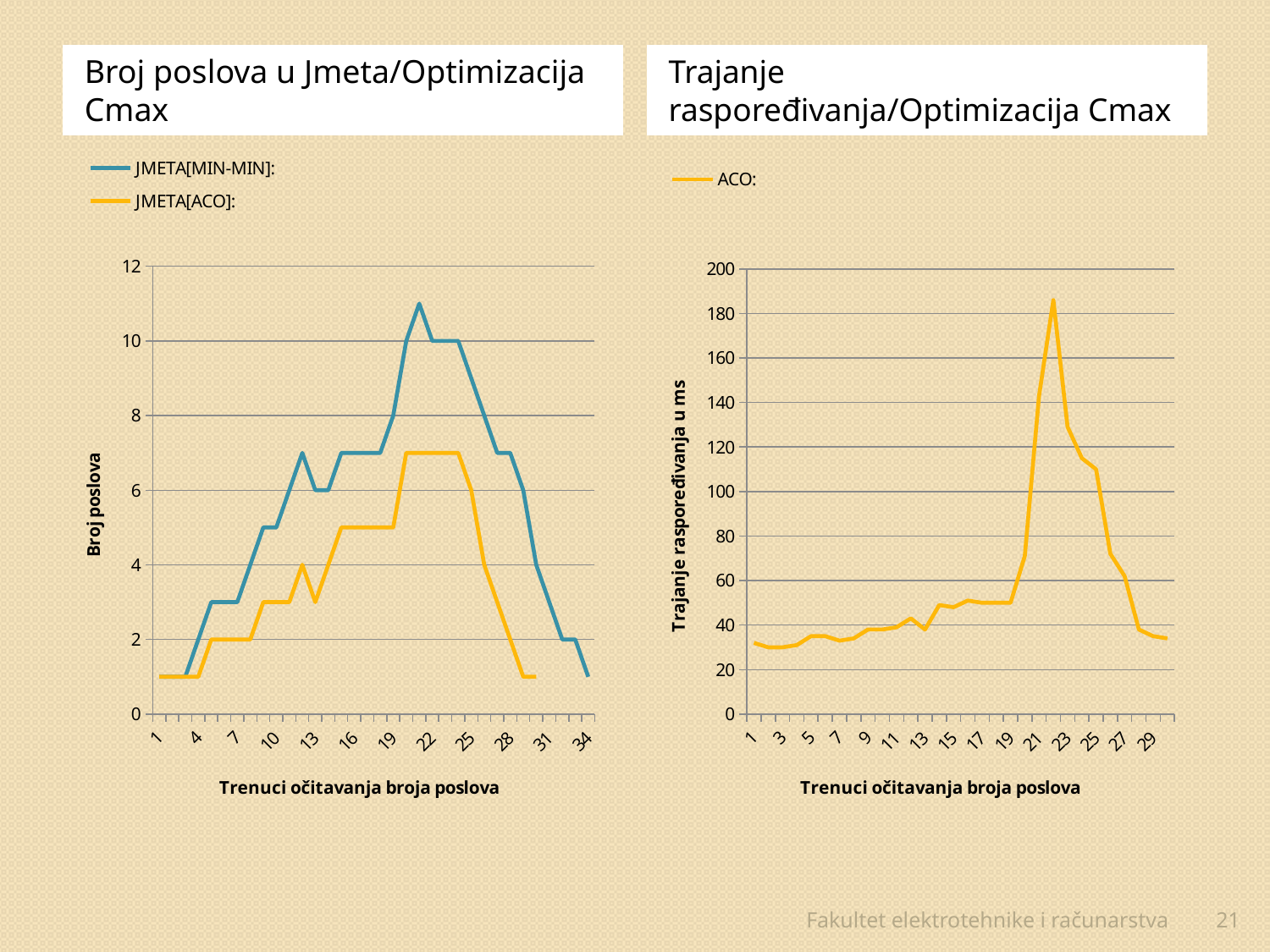
How many series does the legend of the left chart 'Broj poslova u Jmeta/Optimizacija Cmax' list? 2 In the right chart 'Trajanje raspoređivanja/Optimizacija Cmax', at which reading does ACO reach its highest value? 22 In the left chart 'Broj poslova u Jmeta/Optimizacija Cmax', what are the two legend entries? JMETA[MIN-MIN] and JMETA[ACO] In the right chart 'Trajanje raspoređivanja/Optimizacija Cmax', is the ACO value at reading 1 greater or less than 40? less What kind of chart is the left chart, 'Broj poslova u Jmeta/Optimizacija Cmax'? line chart How many series does the legend of the right chart 'Trajanje raspoređivanja/Optimizacija Cmax' list? 1 In the left chart 'Broj poslova u Jmeta/Optimizacija Cmax', which series has the higher value at reading 22, JMETA[MIN-MIN] or JMETA[ACO]? JMETA[MIN-MIN] In the right chart 'Trajanje raspoređivanja/Optimizacija Cmax', is the peak value of ACO greater or less than 160? greater In the left chart 'Broj poslova u Jmeta/Optimizacija Cmax', what is the value of JMETA[MIN-MIN] at reading 23? 10 In the left chart 'Broj poslova u Jmeta/Optimizacija Cmax', is the highest value of JMETA[MIN-MIN] greater or less than 10? greater In the right chart 'Trajanje raspoređivanja/Optimizacija Cmax', do the ACO values rise or fall from reading 23 to reading 29? fall What is the y-axis title of the right chart 'Trajanje raspoređivanja/Optimizacija Cmax'? Trajanje raspoređivanja u ms